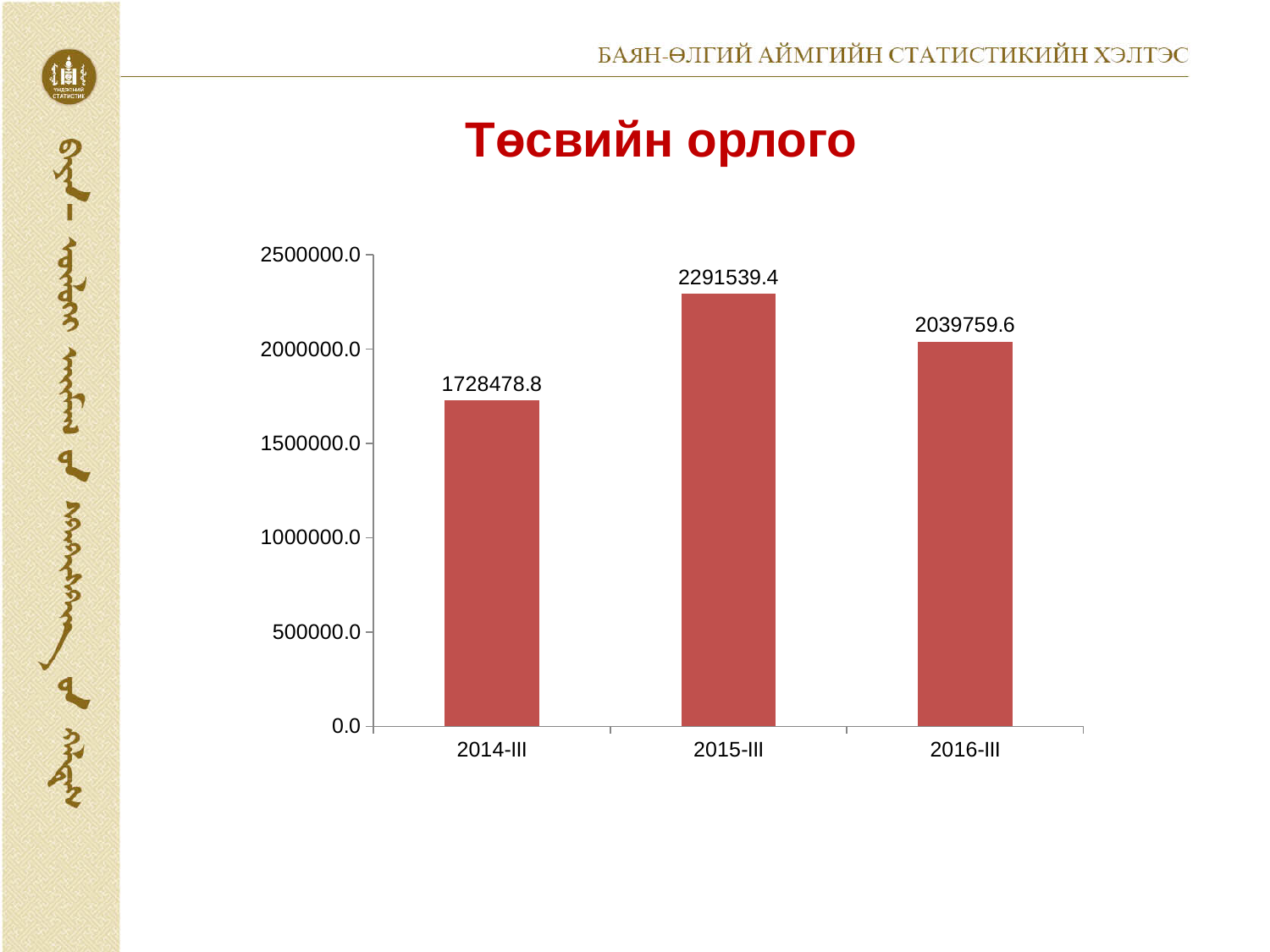
Which period has the highest value? 2015-III What kind of chart is shown on the slide? bar chart What is the value for 2015-III? 2291539.4 Which is larger, the value for 2016-III or the value for 2014-III? 2016-III Which period has the lowest value? 2014-III What is the title of the chart? Төсвийн орлого What is the value for 2016-III? 2039759.6 What is the difference between the values for 2015-III and 2016-III? 251779.8 How many periods are shown on the x axis? 3 Is the value for 2014-III greater or less than 2000000.0? less What is the difference between the values for 2015-III and 2014-III? 563060.6 What is the value for 2014-III? 1728478.8